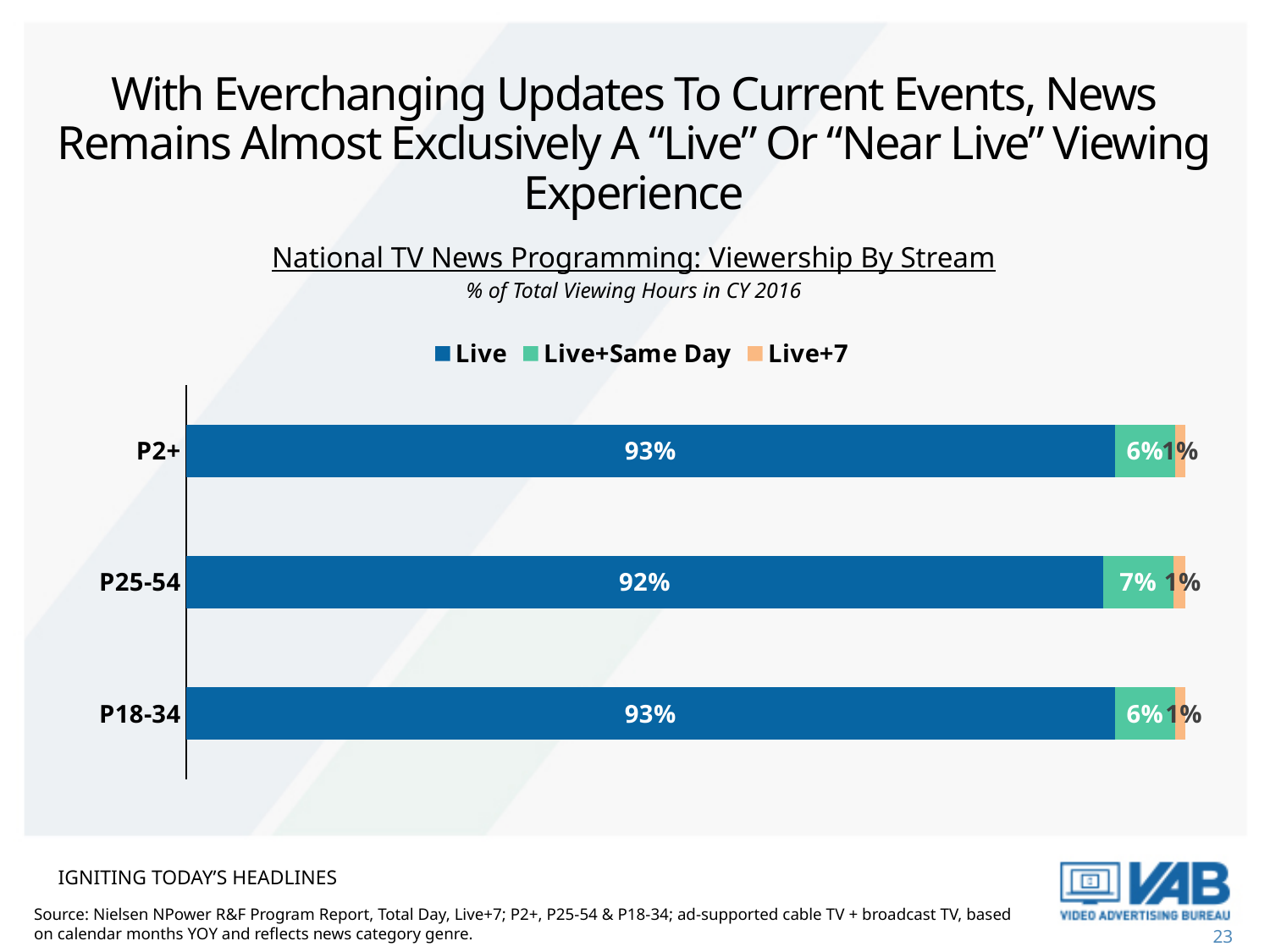
What is the Live+Same Day value for P25-54? 7% How many series does the legend list? 3 What is the total of the stacked bar for P2+? 100% What kind of chart is shown on the slide? Stacked bar chart What is the Live value for P25-54? 92% What is the difference between the Live value for P2+ and the Live value for P25-54? 1% What is the Live+7 value for P18-34? 1% Which demographic has the highest Live+Same Day share? P25-54 Is the Live value for P18-34 larger or smaller than the Live value for P25-54? larger How many demographic groups are shown in the chart? 3 Which demographic has the lowest Live share? P25-54 What is the Live+Same Day value for P2+? 6%